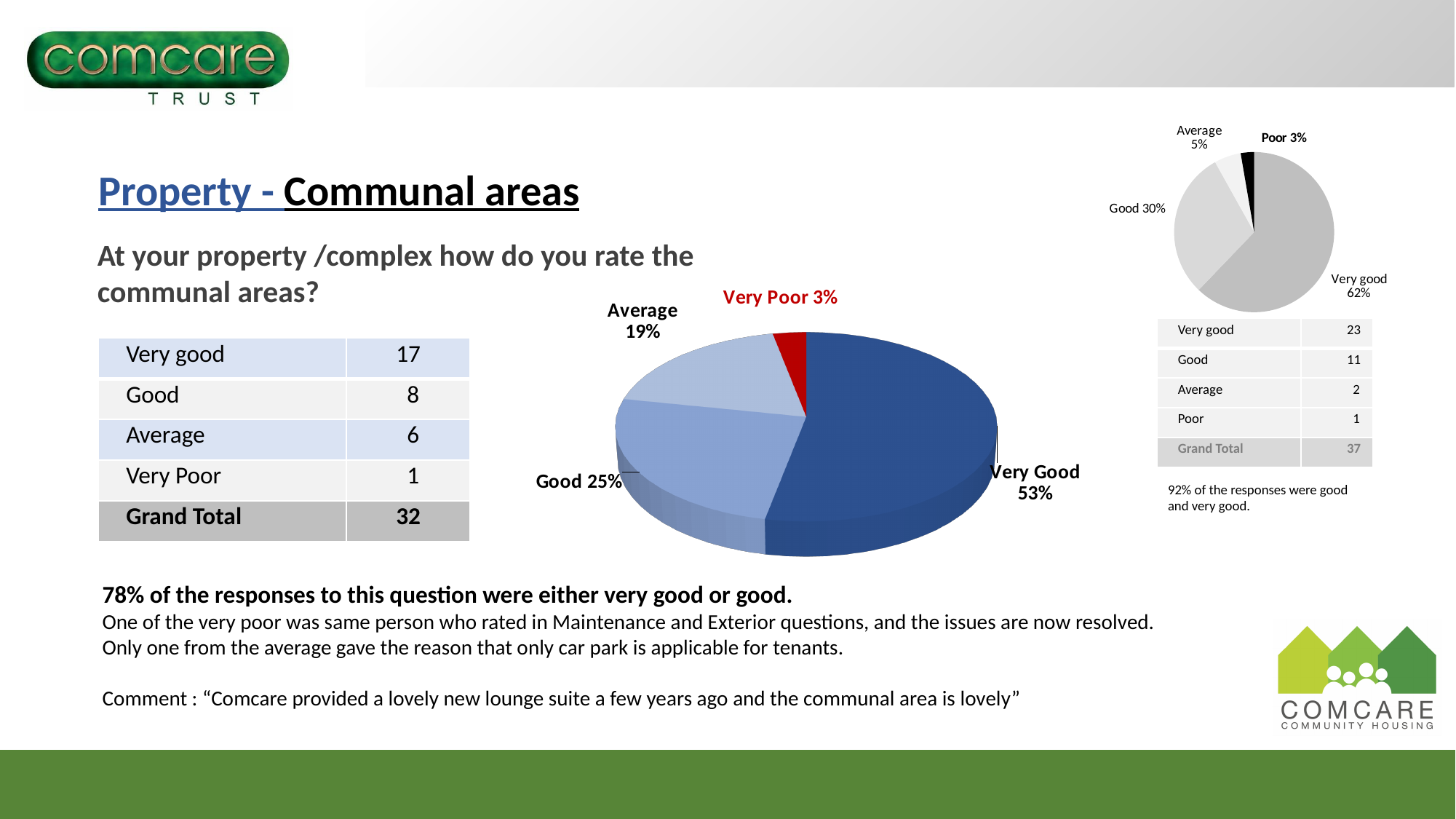
In the small pie chart at the top right, what share is labelled for Very good? 62% In the large centre pie chart, what share is labelled for Average? 19% In the large centre pie chart, what share is labelled for Good? 25% In the large centre pie chart, what is the difference in percentage points between Very Good and Good? 28 In the large centre pie chart, which category has the smallest slice? Very Poor What kind of chart is the large chart in the centre of the slide? pie chart In the small pie chart at the top right, which category has the largest slice? Very good In the large centre pie chart, what colour is the Very Poor slice? red In the large centre pie chart, which category has the largest slice? Very Good How many slices does the large centre pie chart have? 4